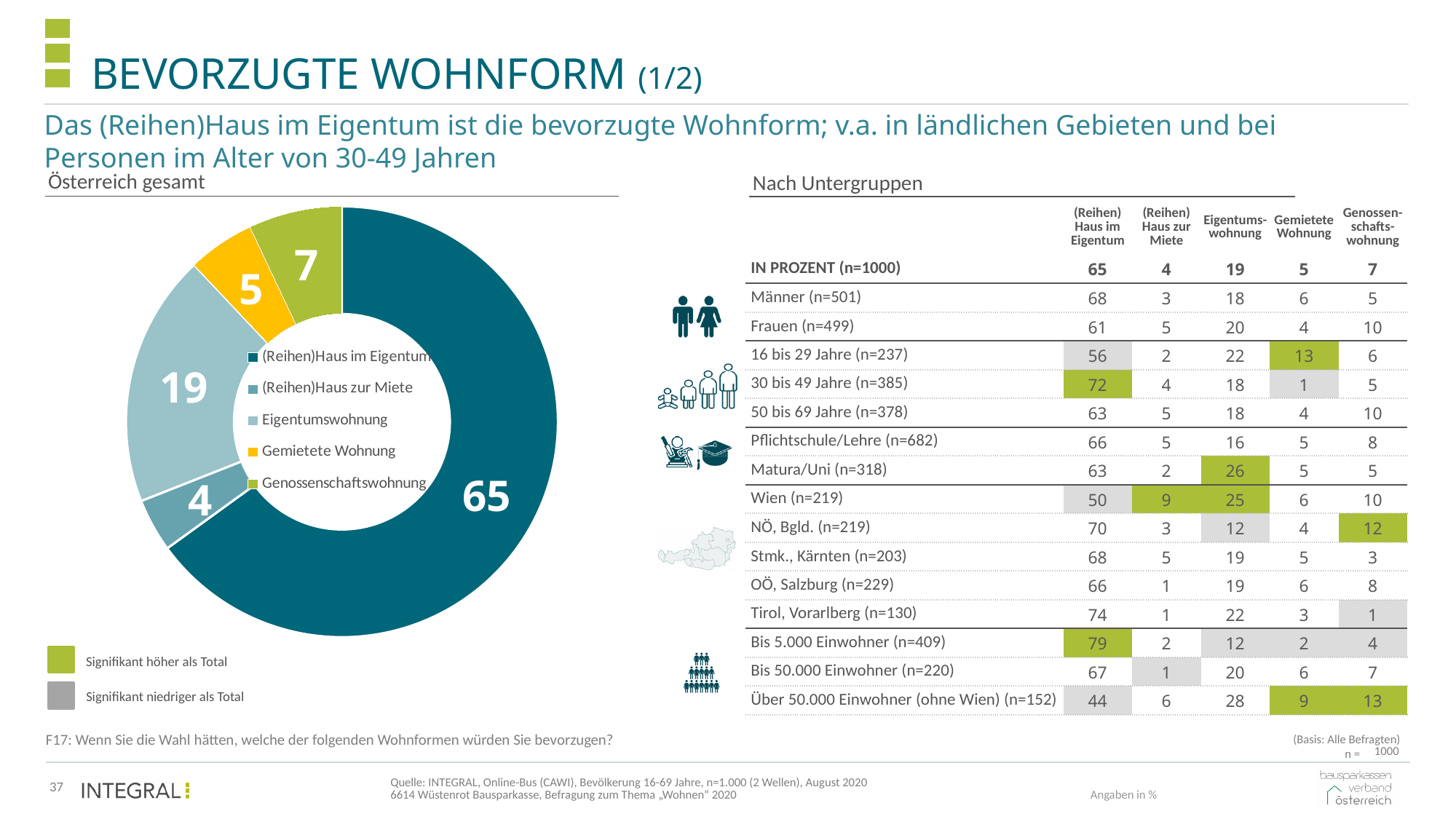
In the "Österreich gesamt" chart, what is the value for Gemietete Wohnung? 5 How many categories does the "Österreich gesamt" chart show? 5 In the "Österreich gesamt" chart, which colour represents Gemietete Wohnung? Yellow In the "Österreich gesamt" chart, what is the difference between the values for (Reihen)Haus im Eigentum and Eigentumswohnung? 46 In the "Österreich gesamt" chart, which category has the smallest share? (Reihen)Haus zur Miete In the "Österreich gesamt" chart, what is the value for (Reihen)Haus im Eigentum? 65 In the "Österreich gesamt" chart, what is the value for Eigentumswohnung? 19 In the "Österreich gesamt" chart, which category has the largest share? (Reihen)Haus im Eigentum In the "Österreich gesamt" chart, which is larger: Genossenschaftswohnung or Gemietete Wohnung? Genossenschaftswohnung In the "Österreich gesamt" chart, what is the value for Genossenschaftswohnung? 7 What kind of chart is shown under "Österreich gesamt"? Pie chart (donut) In the "Österreich gesamt" chart, what is the combined value of (Reihen)Haus zur Miete and Gemietete Wohnung? 9